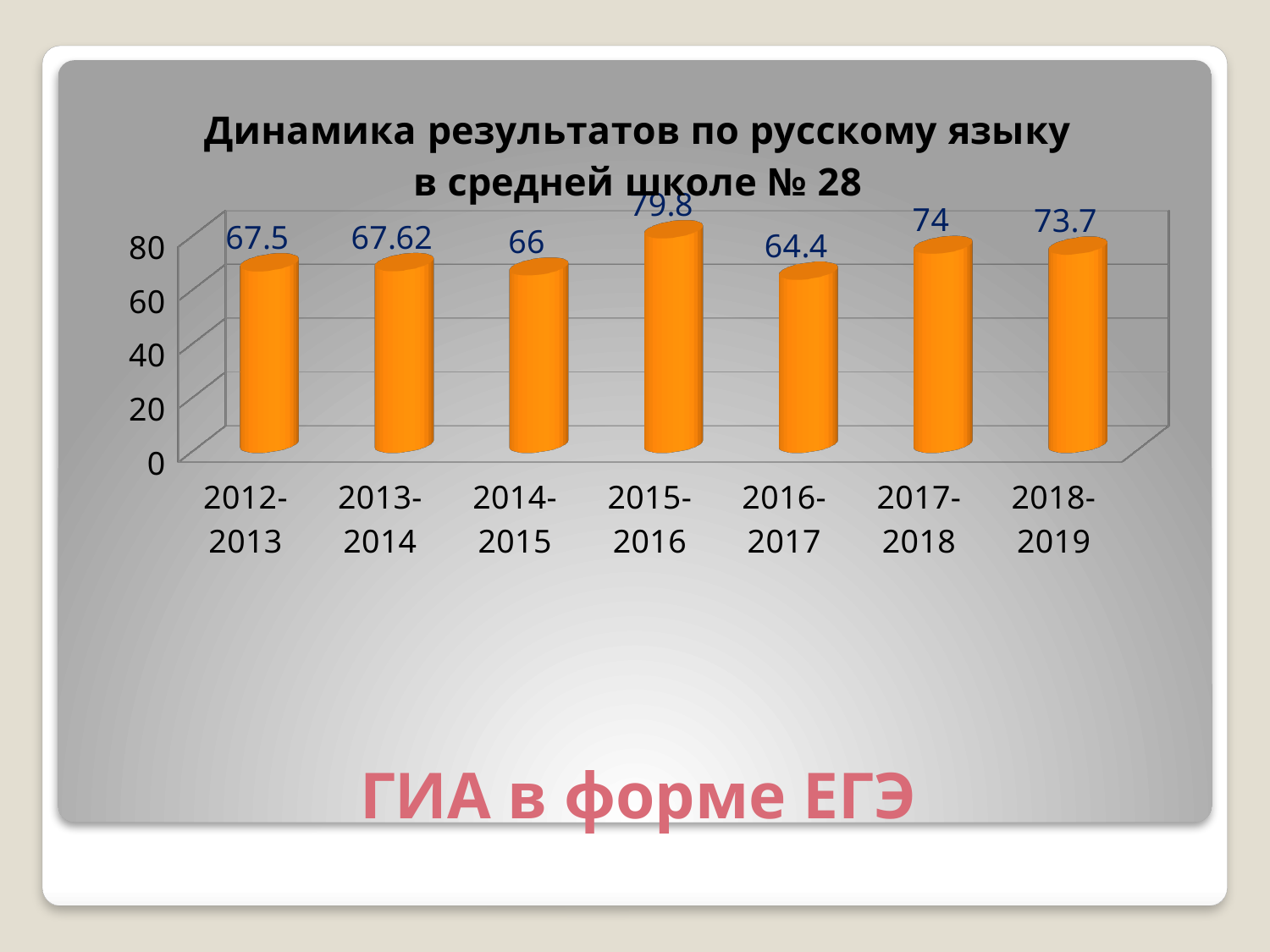
How many school years are shown on the x axis? 7 Which year has the lowest value? 2016-2017 What is the value for 2015-2016? 79.8 What is the difference between the values for 2015-2016 and 2016-2017? 15.4 Which is larger, the value for 2017-2018 or the value for 2018-2019? 2017-2018 What colour are the bars in the chart? orange Does the value rise or fall from 2017-2018 to 2018-2019? fall What is the value for 2012-2013? 67.5 What is the value for 2016-2017? 64.4 Is the value for 2014-2015 greater or less than 60? greater Which year has the highest value? 2015-2016 What kind of chart is shown on the slide? bar chart